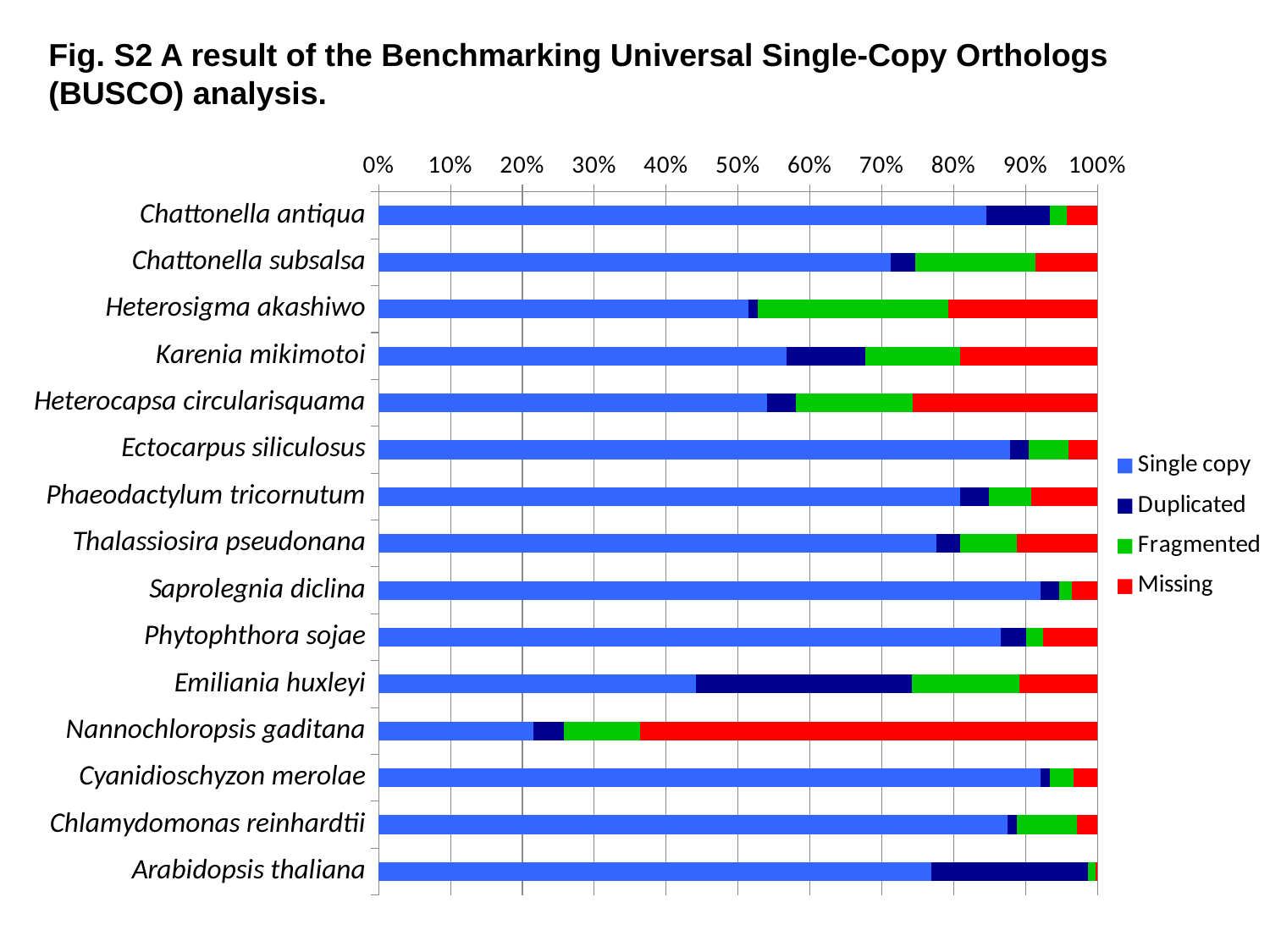
Which colour represents the Missing series in the legend? Red Which has the larger Single copy share, Chattonella antiqua or Chattonella subsalsa? Chattonella antiqua What kind of chart is shown on the slide? Stacked bar chart How many series does the legend list? 4 Which species has the lowest Single copy share? Nannochloropsis gaditana How many species (categories) are plotted on the chart? 15 Which species has the largest Fragmented share? Heterosigma akashiwo Is the Single copy value for Chattonella antiqua greater or less than 80%? greater Which species has the largest Duplicated share? Emiliania huxleyi Is the Single copy value for Nannochloropsis gaditana greater or less than 30%? less Which species has the largest Missing share? Nannochloropsis gaditana Which has the larger Duplicated share, Emiliania huxleyi or Karenia mikimotoi? Emiliania huxleyi